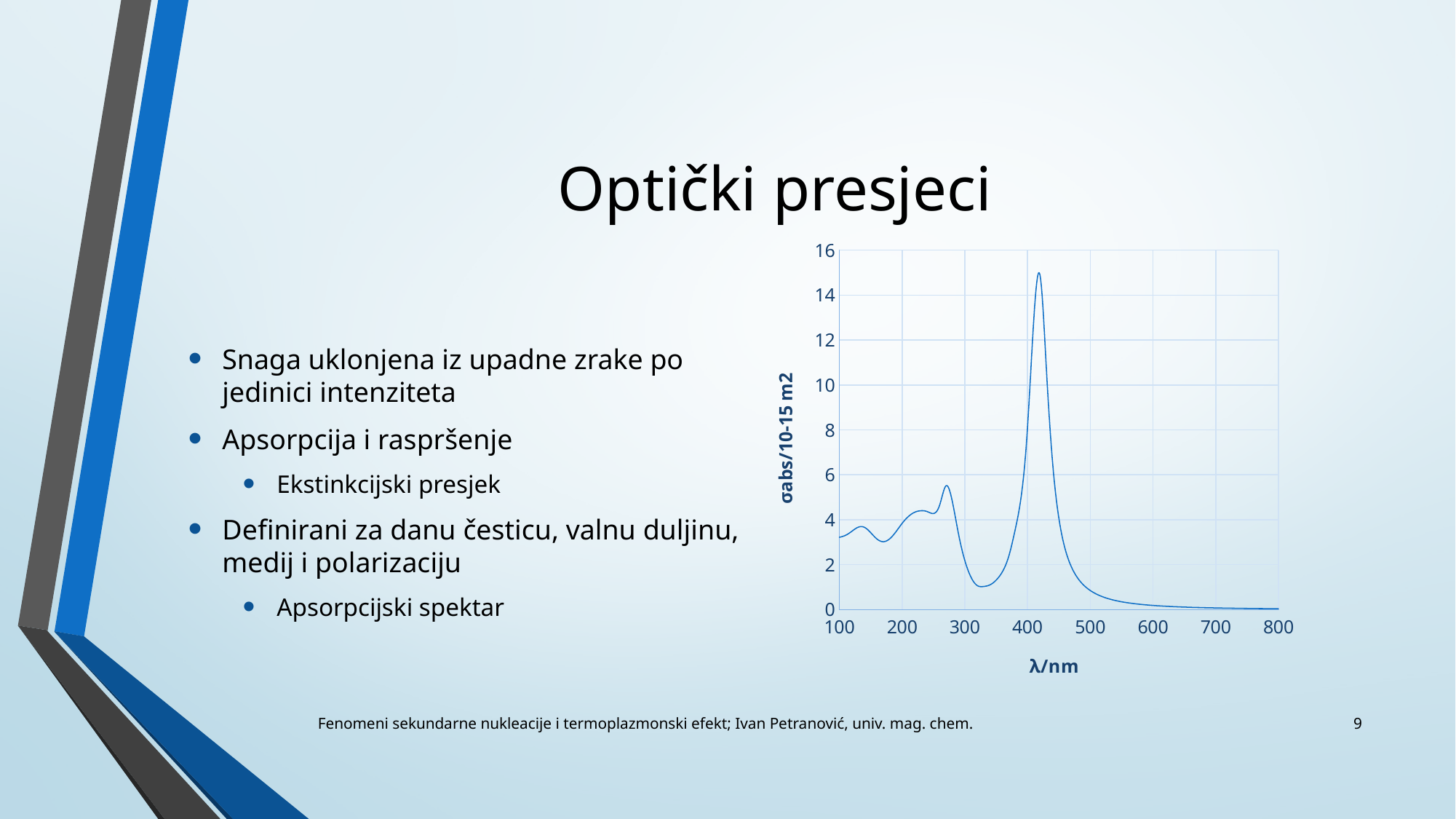
What is the highest value shown on the y axis of the chart? 16 Is the value of the curve at 100 nm greater or less than 2? greater Does the curve rise or fall between 500 nm and 800 nm? fall How many lines are plotted on the chart? 1 Is the value of the curve at 100 nm greater or less than 4? less Is the value of the curve at 600 nm greater or less than 2? less What is the label of the x axis of the chart? λ/nm Is the value of the curve at 700 nm larger or smaller than the value at 100 nm? smaller What kind of chart is shown on the slide? line chart What is the label of the y axis of the chart? σabs/10-15 m2